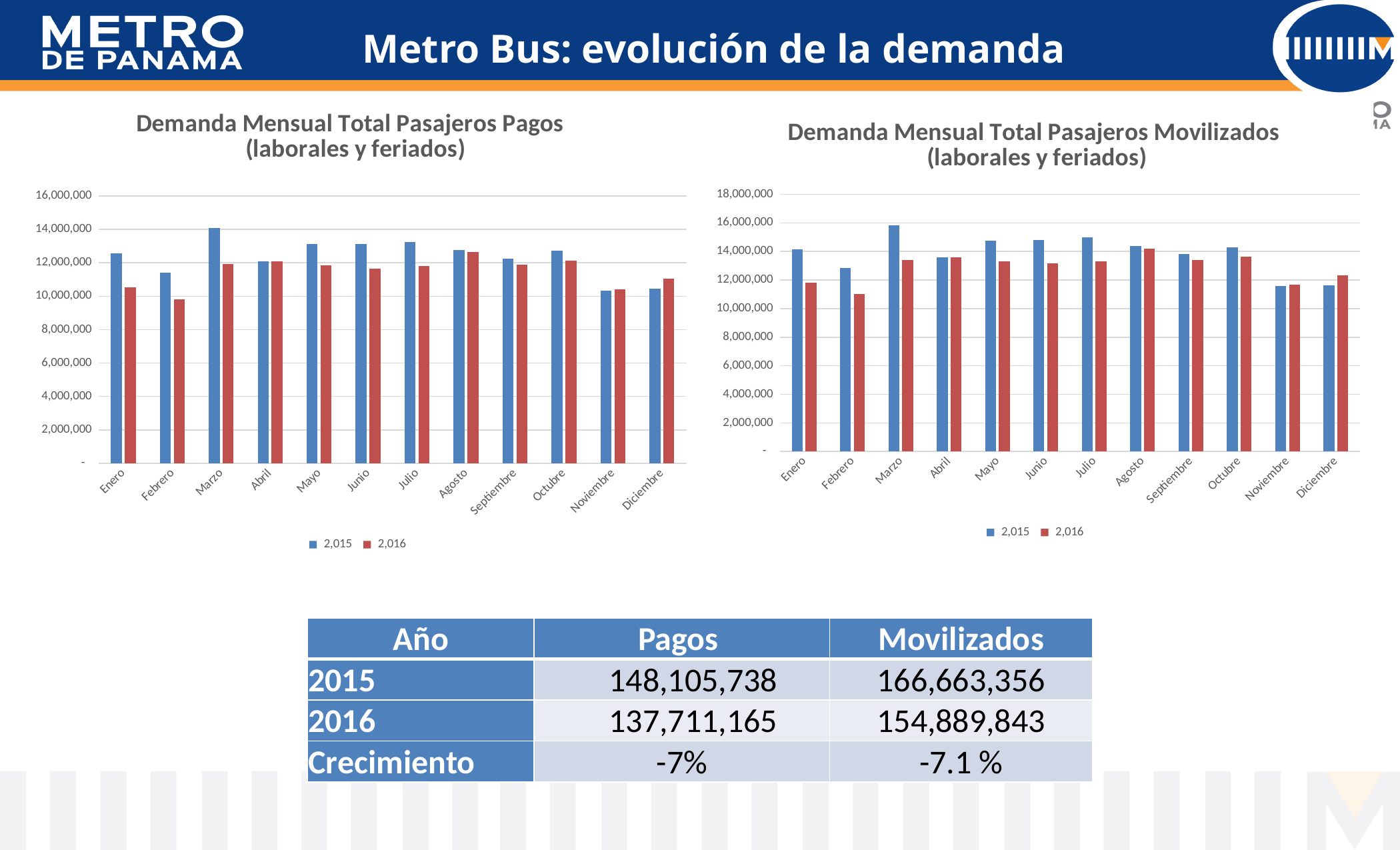
In the right chart ("Demanda Mensual Total Pasajeros Movilizados"), which month has the highest bar for 2,015? Marzo What kind of chart is the "Demanda Mensual Total Pasajeros Pagos" chart on the left? bar chart How many series does the legend of the left chart ("Demanda Mensual Total Pasajeros Pagos") list? 2 In the right chart ("Demanda Mensual Total Pasajeros Movilizados"), is the 2,016 value for Febrero greater or less than 12,000,000? less In the right chart ("Demanda Mensual Total Pasajeros Movilizados"), which series has the larger value for Diciembre, 2,015 or 2,016? 2,016 In the left chart ("Demanda Mensual Total Pasajeros Pagos"), which series has the larger value for Enero, 2,015 or 2,016? 2,015 In the right chart ("Demanda Mensual Total Pasajeros Movilizados"), is the 2,015 value for Marzo greater or less than 14,000,000? greater In the left chart ("Demanda Mensual Total Pasajeros Pagos"), is the 2,015 value for Noviembre greater or less than 12,000,000? less How many months are shown on the x axis of the "Demanda Mensual Total Pasajeros Movilizados" chart on the right? 12 In the left chart ("Demanda Mensual Total Pasajeros Pagos"), which month has the highest bar for 2,015? Marzo In the left chart ("Demanda Mensual Total Pasajeros Pagos"), which month has the lowest bar for 2,016? Febrero